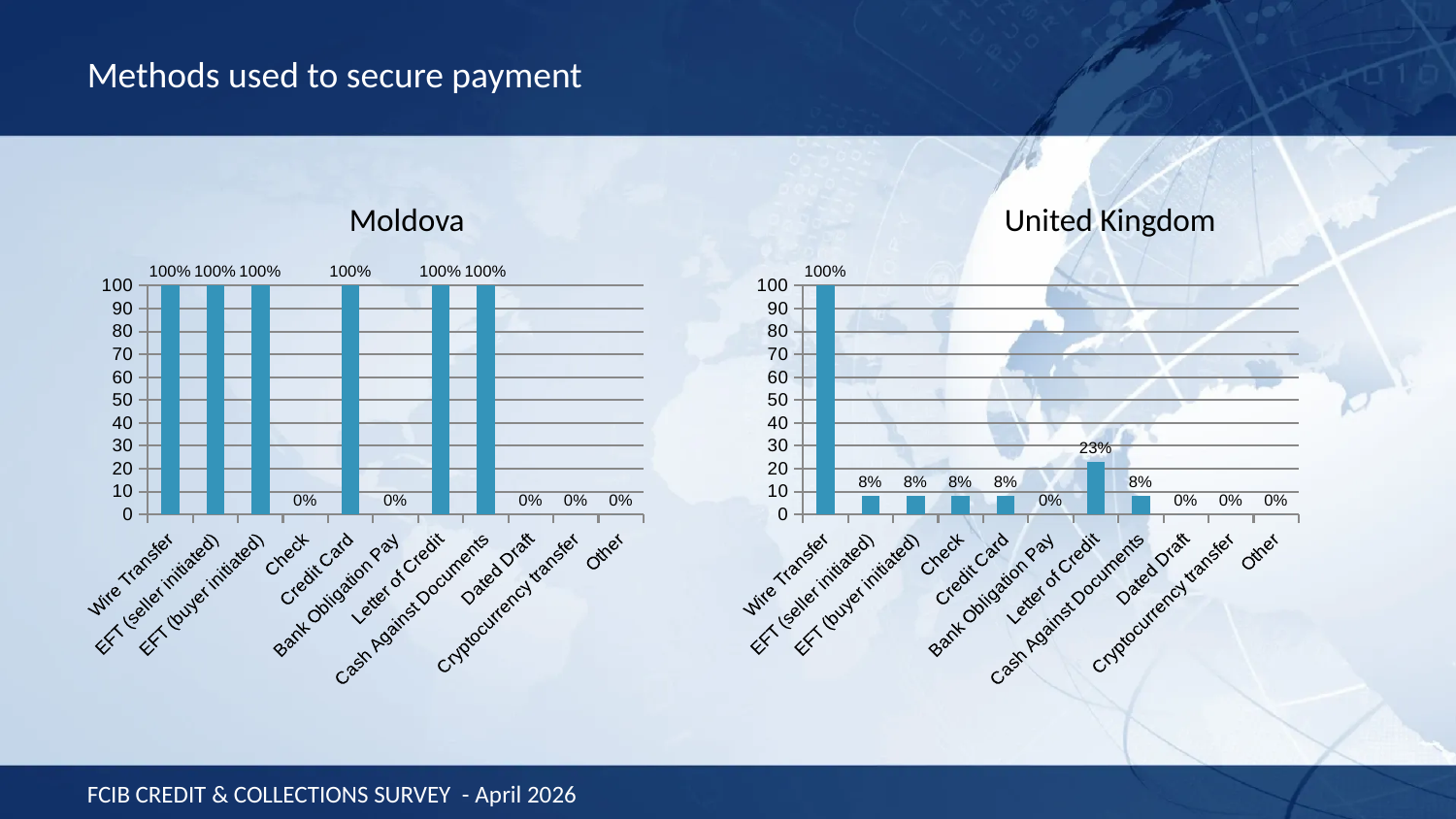
What is the title of the slide? Methods used to secure payment In the United Kingdom chart, which is larger, the value for Letter of Credit or the value for Credit Card? Letter of Credit How many categories are shown on the x axis of the Moldova chart? 11 In the Moldova chart, what is the value for Check? 0% In the United Kingdom chart, what is the value for Wire Transfer? 100% In the United Kingdom chart, what is the value for Cash Against Documents? 8% In the United Kingdom chart, what is the value for Letter of Credit? 23% In the Moldova chart, what is the value for Credit Card? 100% In the United Kingdom chart, which category has the highest value? Wire Transfer In the United Kingdom chart, what is the difference between the values for Wire Transfer and Letter of Credit? 77% What kind of chart is the United Kingdom chart? Bar chart In the Moldova chart, which is larger, the value for Bank Obligation Pay or the value for Letter of Credit? Letter of Credit